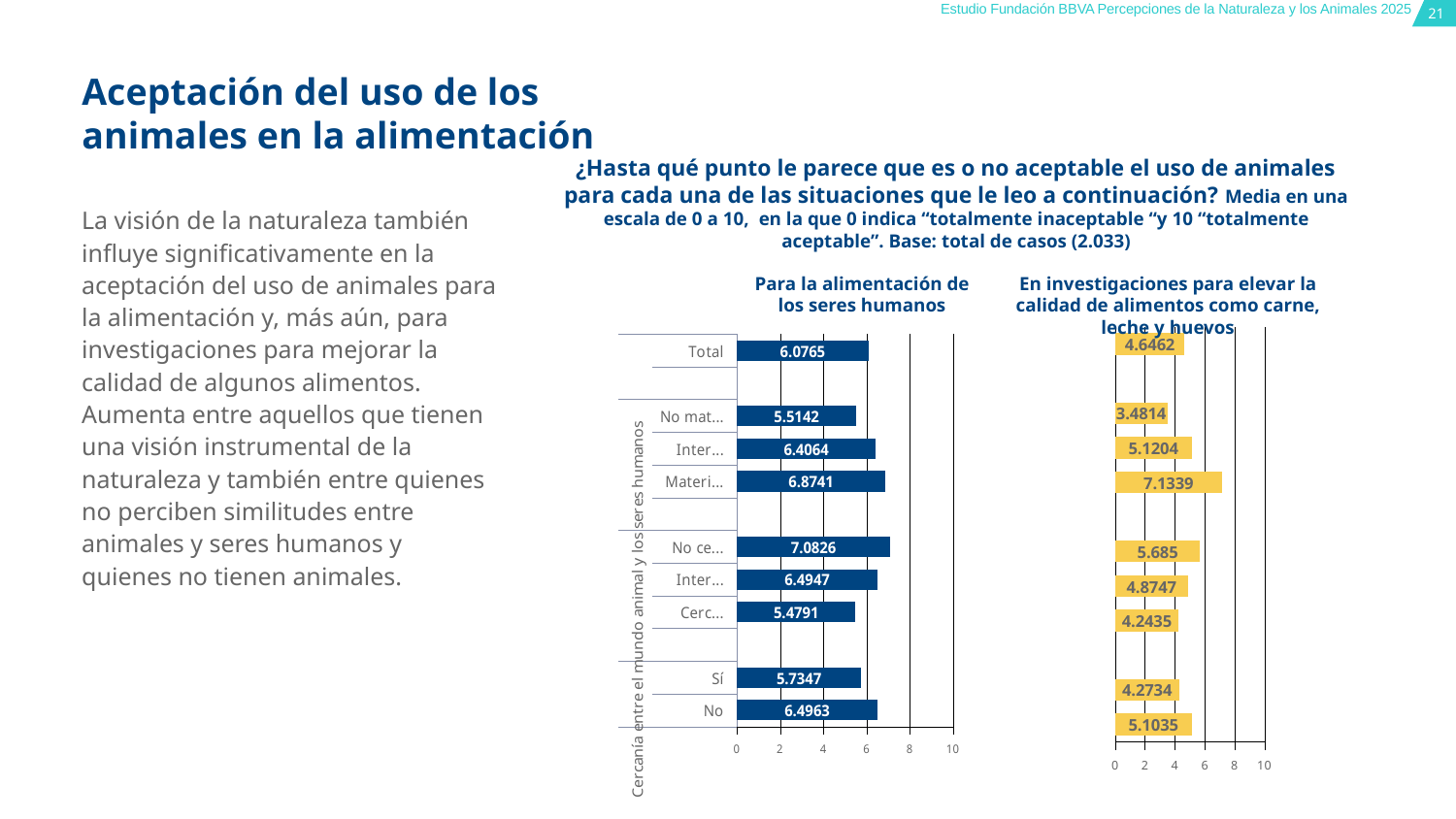
What is the difference between the Total value in the chart 'Para la alimentación de los seres humanos' and the Total value in the chart 'En investigaciones para elevar la calidad de alimentos como carne, leche y huevos'? 1.4303 In the chart 'En investigaciones para elevar la calidad de alimentos como carne, leche y huevos', what is the lowest value shown? 3.4814 In the chart 'En investigaciones para elevar la calidad de alimentos como carne, leche y huevos', what is the value for Total? 4.6462 In the chart 'En investigaciones para elevar la calidad de alimentos como carne, leche y huevos', is the value for Total greater or less than 6? less In the chart 'Para la alimentación de los seres humanos', what is the highest value shown? 7.0826 How many bars are shown in the chart 'Para la alimentación de los seres humanos'? 9 In the chart 'Para la alimentación de los seres humanos', what is the value for Total? 6.0765 In the chart 'Para la alimentación de los seres humanos', which is larger, the value for 'Sí' or the value for 'No'? No In the chart 'En investigaciones para elevar la calidad de alimentos como carne, leche y huevos', what is the value for 'No'? 5.1035 In the chart 'En investigaciones para elevar la calidad de alimentos como carne, leche y huevos', what is the highest value shown? 7.1339 What kind of chart is 'Para la alimentación de los seres humanos'? bar chart In the chart 'Para la alimentación de los seres humanos', what is the value for 'Sí'? 5.7347